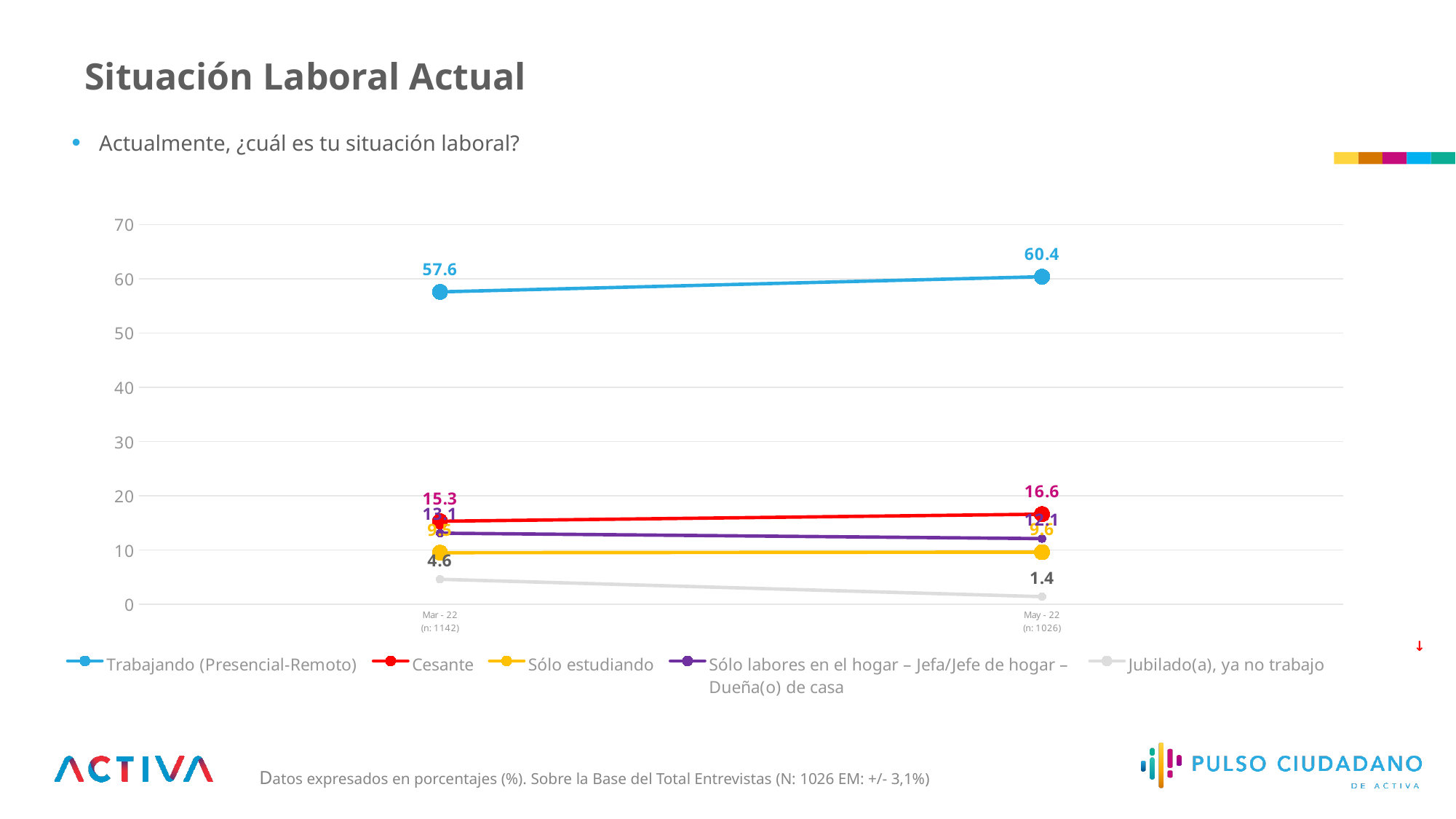
What is the value for Sólo estudiando in May - 22? 9.6 What is the value for Trabajando (Presencial-Remoto) in May - 22? 60.4 By how much did the value for Trabajando (Presencial-Remoto) change from Mar - 22 to May - 22? 2.8 Which series has the highest value in May - 22? Trabajando (Presencial-Remoto) Does the value for Jubilado(a), ya no trabajo rise or fall from Mar - 22 to May - 22? fall What is the value for Cesante in May - 22? 16.6 What is the value for Trabajando (Presencial-Remoto) in Mar - 22? 57.6 What is the value for Jubilado(a), ya no trabajo in Mar - 22? 4.6 Which series has the lowest value in May - 22? Jubilado(a), ya no trabajo Is the value for Sólo labores en el hogar – Jefa/Jefe de hogar – Dueña(o) de casa in May - 22 greater or less than 10? greater What is the difference between the Jubilado(a), ya no trabajo values in Mar - 22 and May - 22? 3.2 How many series does the legend list? 5